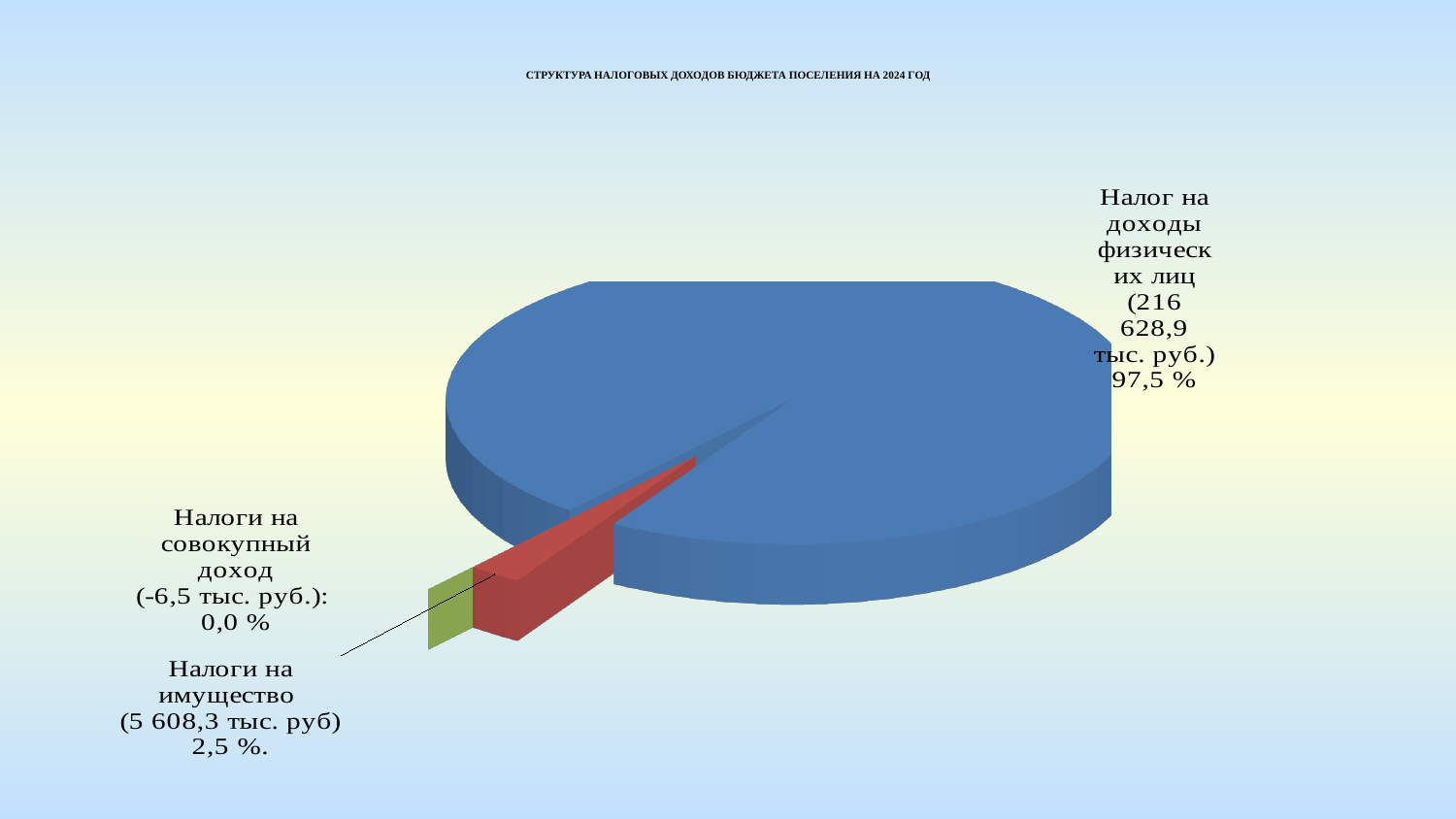
What is the title of the chart? СТРУКТУРА НАЛОГОВЫХ ДОХОДОВ БЮДЖЕТА ПОСЕЛЕНИЯ НА 2024 ГОД How many slices does the pie chart have? 3 Which category has the smallest share of the pie? Налоги на совокупный доход What share of the pie does "Налоги на имущество" have? 2,5 % Which category has the largest share of the pie? Налог на доходы физических лиц What kind of chart is shown on the slide? Pie chart What share of the pie does "Налог на доходы физических лиц" have? 97,5 % Which is larger: the share of "Налоги на имущество" or the share of "Налоги на совокупный доход"? Налоги на имущество What is the value in тыс. руб. for "Налоги на имущество"? 5 608,3 тыс. руб What share of the pie does "Налоги на совокупный доход" have? 0,0 % What is the value in тыс. руб. for "Налоги на совокупный доход"? -6,5 тыс. руб. What is the value in тыс. руб. for "Налог на доходы физических лиц"? 216 628,9 тыс. руб.